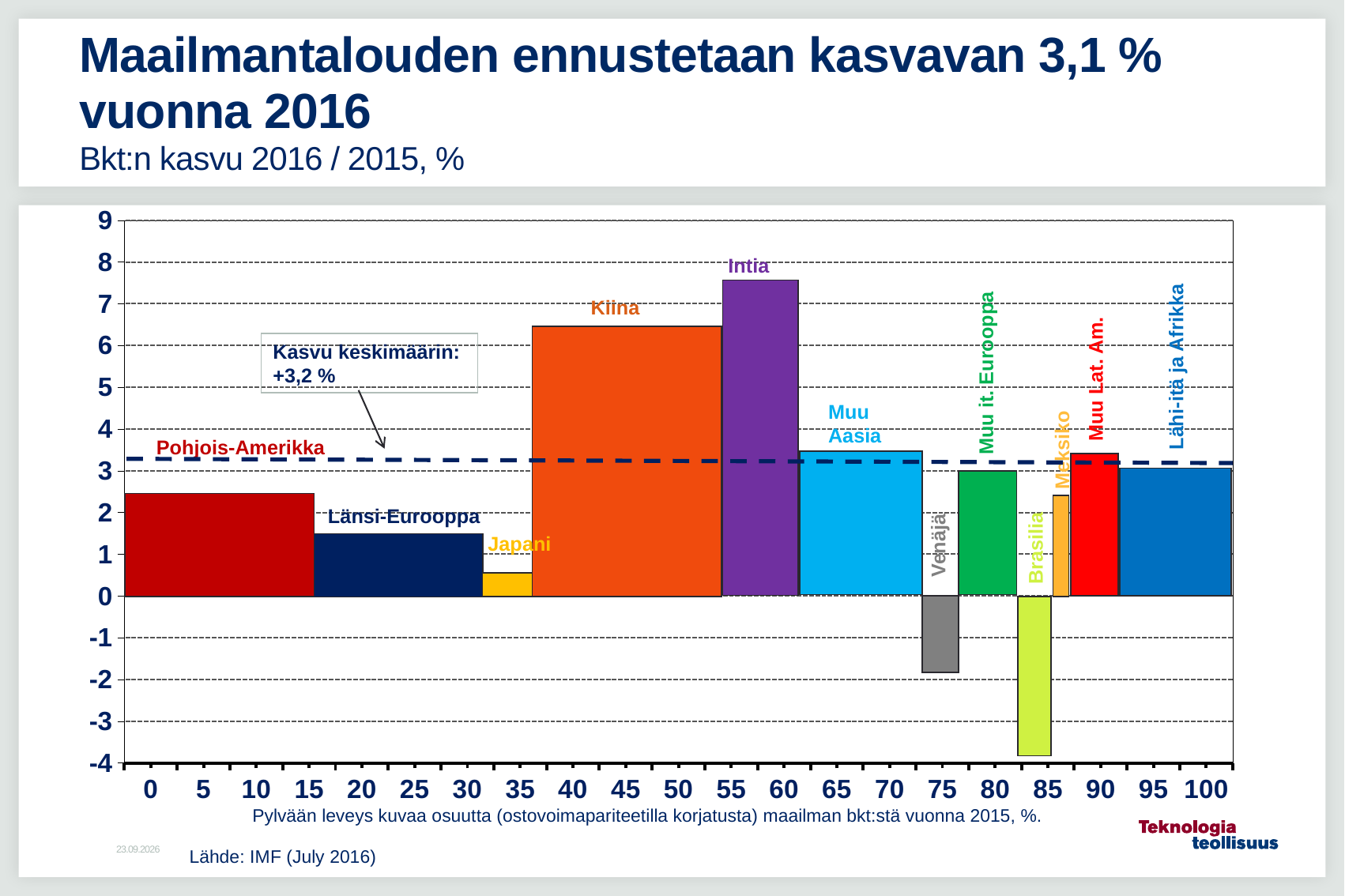
Which has the larger value, Pohjois-Amerikka or Länsi-Eurooppa? Pohjois-Amerikka Which has the larger value, Kiina or Intia? Intia Which region has the highest GDP growth forecast in the chart? Intia How many regions or countries are plotted as bars in the chart? 12 What kind of chart is shown on the slide? bar chart Is the value for Japani greater or less than 1? less Which region has the lowest GDP growth forecast in the chart? Brasilia Is the value for Venäjä greater or less than -1? less Is the value for Pohjois-Amerikka greater or less than 3? less What average growth value is shown by the dashed line annotation in the chart? +3,2 %